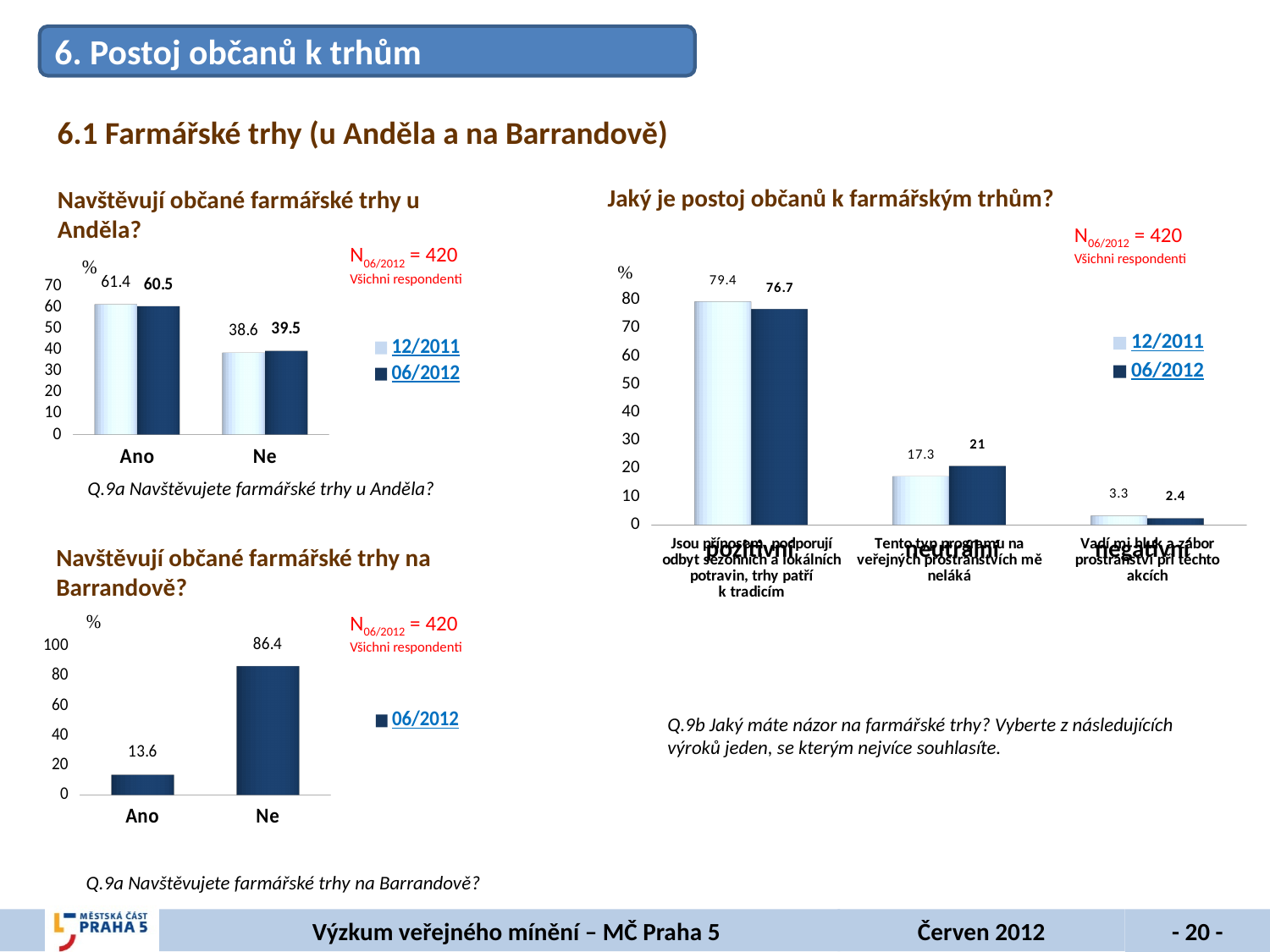
In the chart 'Jaký je postoj občanů k farmářským trhům?', how many categories are shown on the x axis? 3 In the chart 'Jaký je postoj občanů k farmářským trhům?', what is the 06/2012 value for the first (pozitivní) category? 76.7 In the chart 'Jaký je postoj občanů k farmářským trhům?', which is larger for the third (negativní) category: the 12/2011 value or the 06/2012 value? 12/2011 In the chart 'Jaký je postoj občanů k farmářským trhům?', what is the 12/2011 value for the second (neutrální) category? 17.3 In the chart 'Navštěvují občané farmářské trhy u Anděla?', how many series does the legend list? 2 In the chart 'Navštěvují občané farmářské trhy u Anděla?', what is the difference between the 12/2011 and 06/2012 values for 'Ne'? 0.9 In the chart 'Navštěvují občané farmářské trhy na Barrandově?', which category has the lowest value? Ano What kind of chart is 'Navštěvují občané farmářské trhy na Barrandově?'? bar chart In the chart 'Navštěvují občané farmářské trhy na Barrandově?', what is the value for 'Ne'? 86.4 In the chart 'Navštěvují občané farmářské trhy u Anděla?', what is the 12/2011 value for 'Ne'? 38.6 In the chart 'Navštěvují občané farmářské trhy u Anděla?', what is the 06/2012 value for 'Ano'? 60.5 In the chart 'Navštěvují občané farmářské trhy na Barrandově?', what is the difference between the values for 'Ne' and 'Ano'? 72.8